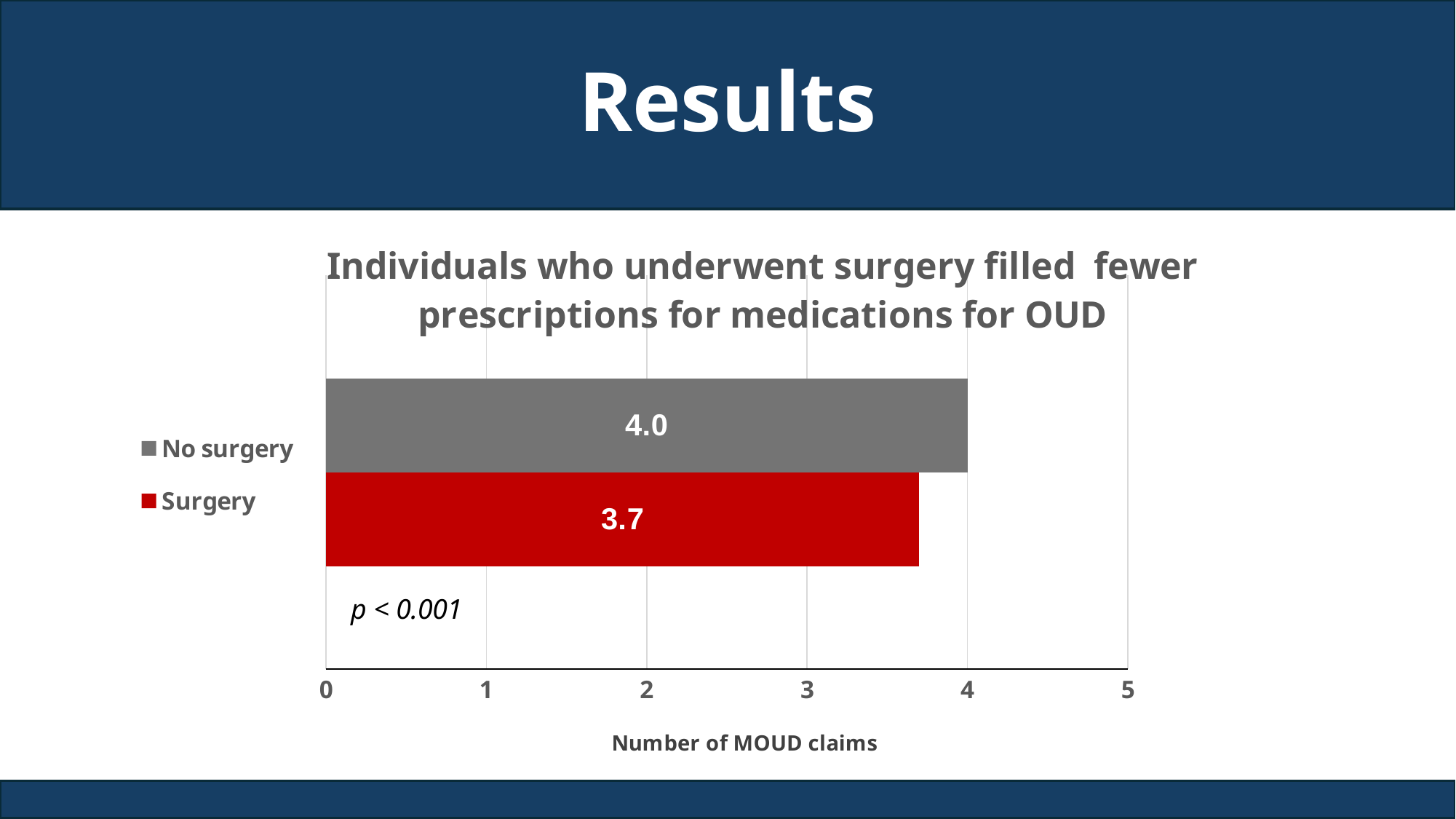
What is the number of MOUD claims for the No surgery group? 4.0 How many bars are plotted in the chart? 2 Which group has the lower number of MOUD claims? Surgery What is the number of MOUD claims for the Surgery group? 3.7 What kind of chart is shown on the slide? Bar chart What is the label of the x axis? Number of MOUD claims How many series does the legend list? 2 Is the value for Surgery greater or less than 4? less Which group has the higher number of MOUD claims? No surgery Is the value for Surgery greater or less than the value for No surgery? less What is the difference in MOUD claims between the No surgery and Surgery groups? 0.3 What colour is the bar for the Surgery group? Red